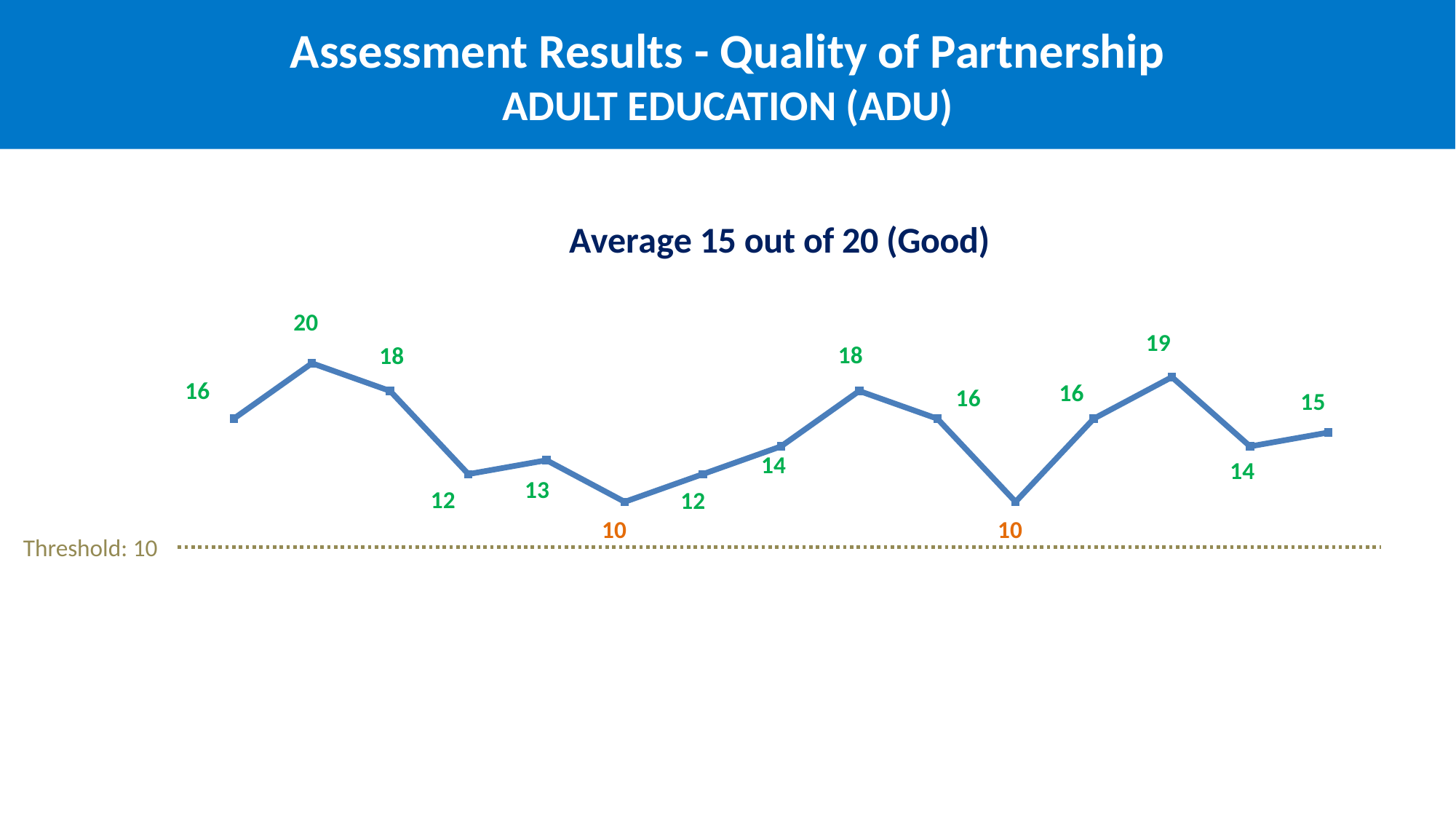
What is the difference between the highest value (20) and the lowest value (10) on the line? 10 What is the highest value plotted on the line? 20 What threshold value is marked by the dotted line? 10 What average score is stated above the chart? 15 out of 20 (Good) How many data points are labelled in orange, sitting at the threshold value? 2 What is the lowest value plotted on the line? 10 What is the value of the last data point on the line? 15 What is the value of the first data point on the line? 16 What is the value of the second data point on the line? 20 Which is larger, the value of the second data point or the value of the third data point? the second data point (20) How many data points are plotted on the line? 15 What kind of chart is shown on the slide? line chart